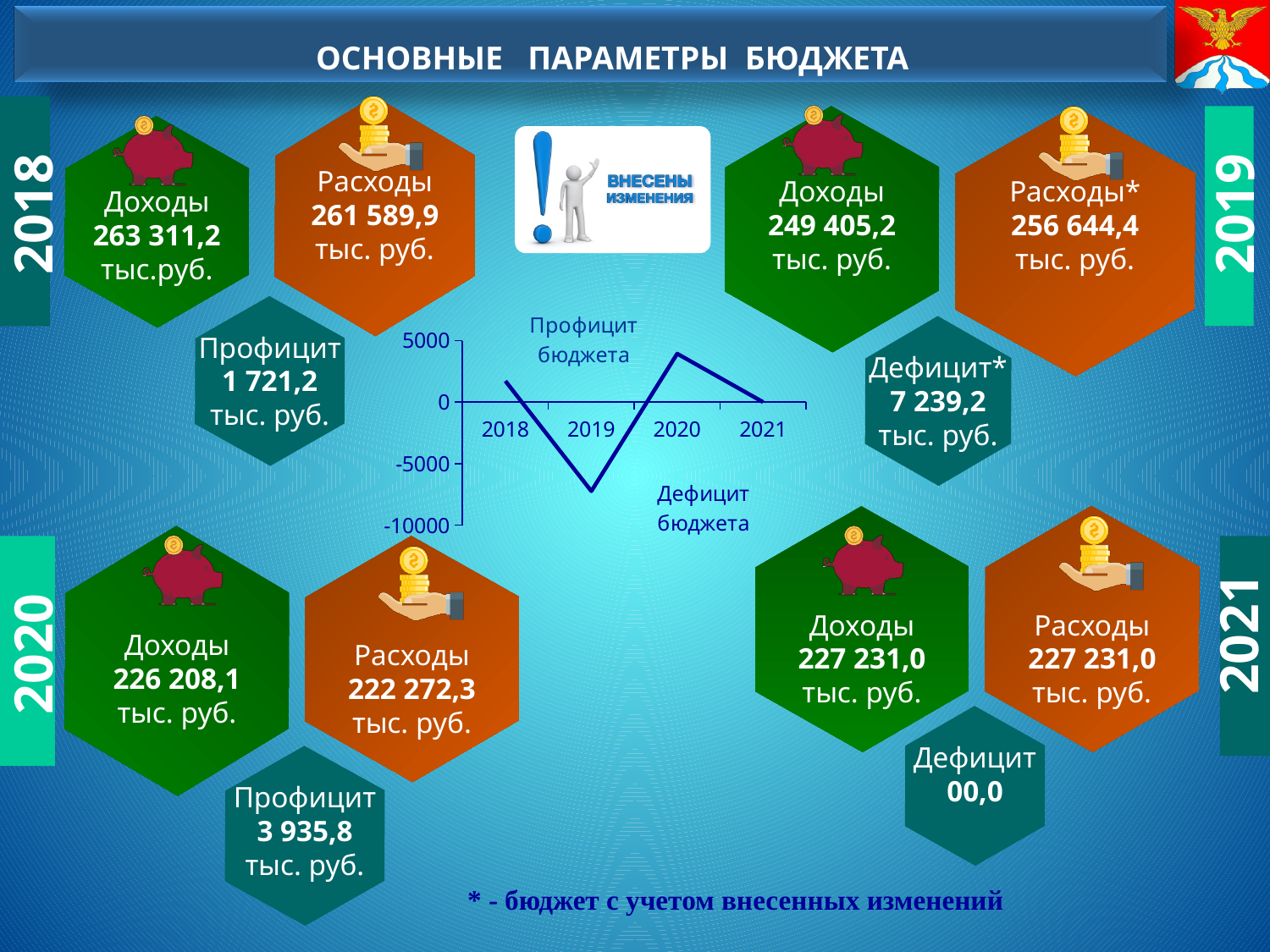
What is the lowest tick value shown on the y axis of the line chart? -10000 What kind of chart is shown in the centre of the slide? line chart On the line chart, is the value for 2020 greater or less than 5000? less On the line chart, which year has the larger value, 2018 or 2020? 2020 Which year has the lowest point on the line chart? 2019 Does the line rise or fall from 2019 to 2020? rise How many years are plotted on the x axis of the line chart? 4 Does the line rise or fall from 2018 to 2019? fall On the line chart, is the value for 2019 greater or less than -5000? less On the line chart, is the value for 2018 greater or less than 0? greater Which year has the highest point on the line chart? 2020 On the line chart, which year has the larger value, 2019 or 2021? 2021